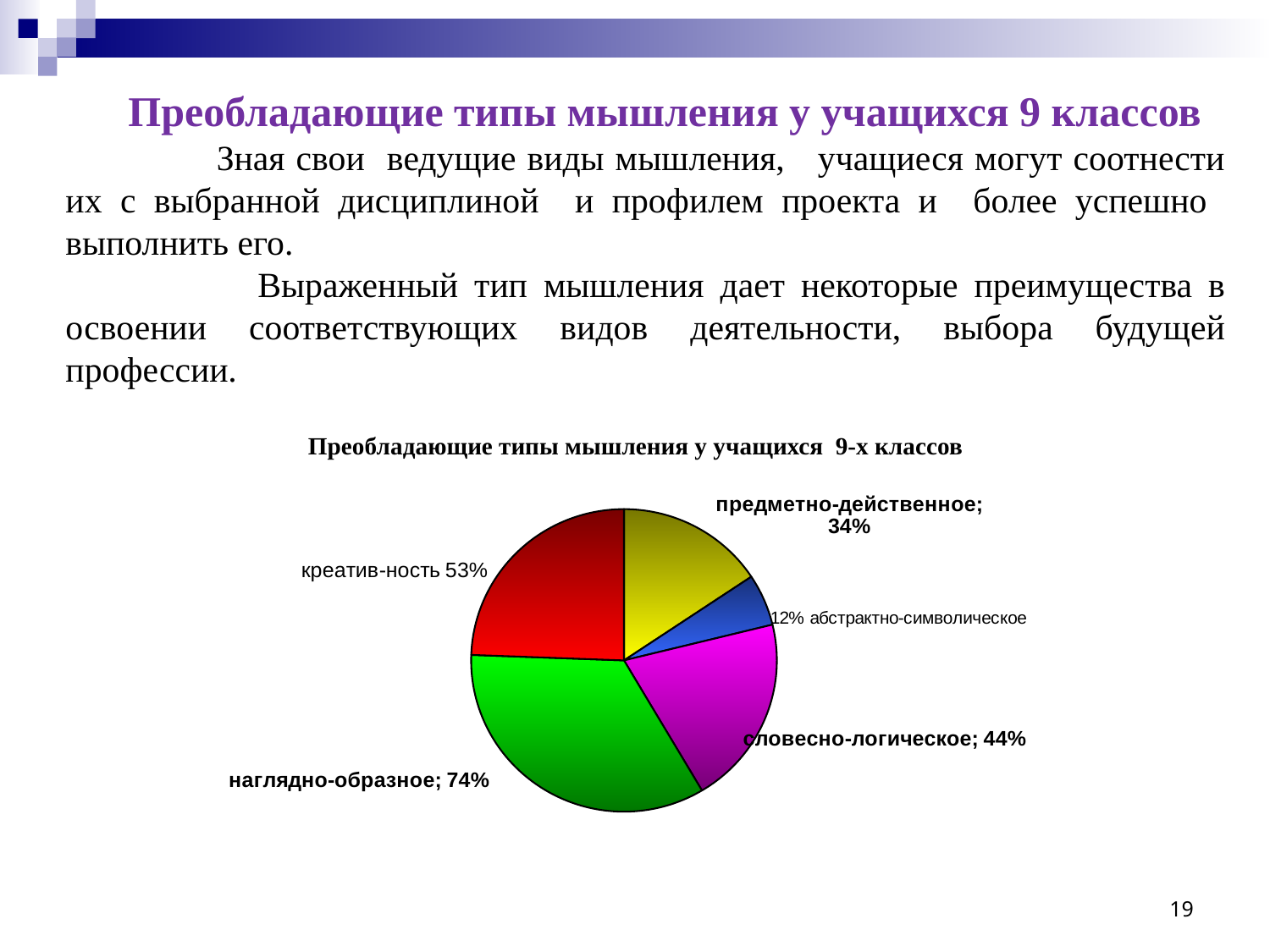
Which type of thinking has the lowest value in the pie chart? абстрактно-символическое What kind of chart is shown on the slide? pie chart Which type of thinking has the highest value in the pie chart? наглядно-образное What value is shown for словесно-логическое in the pie chart? 44% How many types of thinking are shown in the pie chart? 5 What value is shown for абстрактно-символическое in the pie chart? 12% What is the difference between the values for наглядно-образное and абстрактно-символическое? 62 percentage points What value is shown for предметно-действенное in the pie chart? 34% What is the difference between the values for словесно-логическое and предметно-действенное? 10 percentage points What value is shown for креатив-ность in the pie chart? 53% What value is shown for наглядно-образное in the pie chart? 74% Which has a larger value, креатив-ность or словесно-логическое? креатив-ность